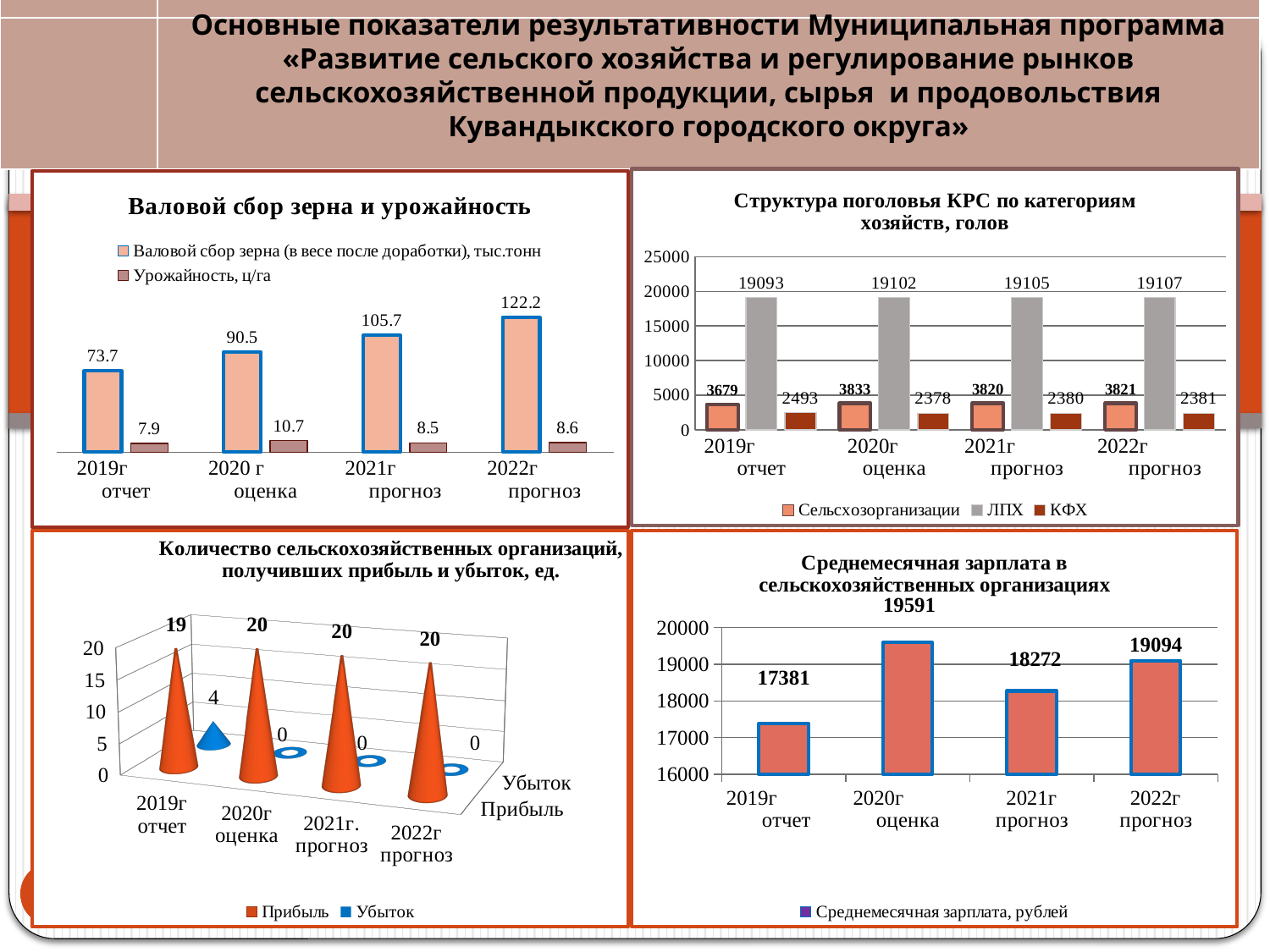
In the chart 'Среднемесячная зарплата в сельскохозяйственных организациях', which year has the lowest value? 2019г отчет In the chart 'Количество сельскохозяйственных организаций, получивших прибыль и убыток, ед.', what is the value of Убыток for 2019г отчет? 4 In the chart 'Среднемесячная зарплата в сельскохозяйственных организациях', what is the difference between the values for 2020г оценка and 2021г прогноз? 1319 In the chart 'Структура поголовья КРС по категориям хозяйств, голов', how many series does the legend list? 3 In the chart 'Структура поголовья КРС по категориям хозяйств, голов', what is the value for ЛПХ in 2021г прогноз? 19105 In the chart 'Валовой сбор зерна и урожайность', which year has the highest 'Урожайность, ц/га'? 2020 г оценка In the chart 'Структура поголовья КРС по категориям хозяйств, голов', what is the total of the three categories for 2020г оценка? 25313 In the chart 'Валовой сбор зерна и урожайность', what is the difference between the gross grain harvest values for 2021г прогноз and 2019г отчет? 32.0 In the chart 'Валовой сбор зерна и урожайность', does the gross grain harvest rise or fall from 2019г to 2022г? rise In the chart 'Количество сельскохозяйственных организаций, получивших прибыль и убыток, ед.', how many categories are shown on the x axis? 4 In the chart 'Валовой сбор зерна и урожайность', what is the value of 'Валовой сбор зерна (в весе после доработки), тыс.тонн' for 2022г прогноз? 122.2 In the chart 'Структура поголовья КРС по категориям хозяйств, голов', which is larger in 2019г отчет: Сельскохозорганизации or КФХ? Сельскохозорганизации